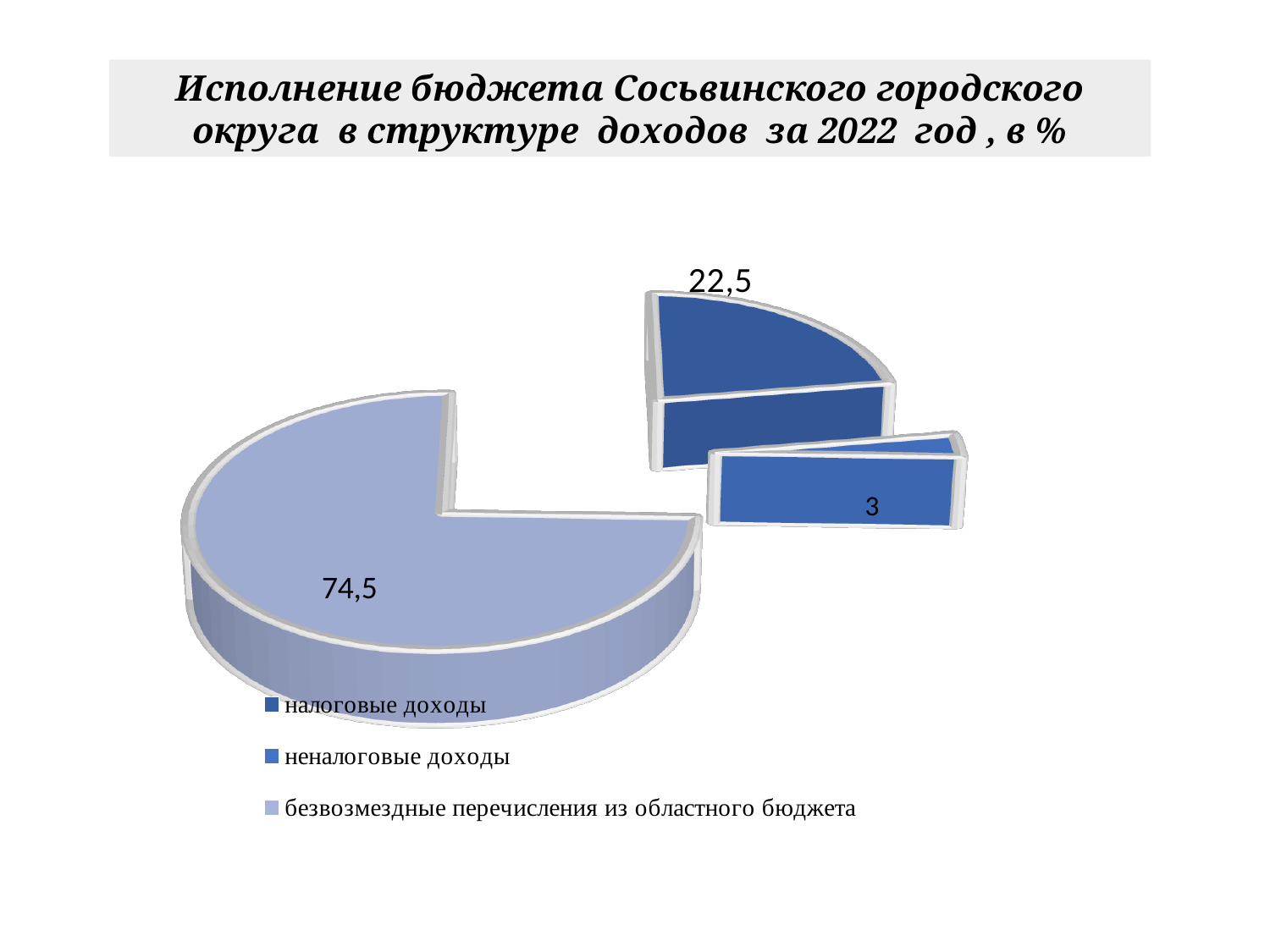
What is the difference between the values for безвозмездные перечисления из областного бюджета and налоговые доходы? 52 Which category has the smallest slice of the pie? неналоговые доходы How many entries does the legend list? 3 What kind of chart is shown on the slide? pie chart What is the value for налоговые доходы? 22,5 What is the value for неналоговые доходы? 3 What is the title of the chart? Исполнение бюджета Сосьвинского городского округа в структуре доходов за 2022 год , в % What is the difference between the values for налоговые доходы and неналоговые доходы? 19,5 What is the value for безвозмездные перечисления из областного бюджета? 74,5 Which is larger, налоговые доходы or неналоговые доходы? налоговые доходы Which category has the largest slice of the pie? безвозмездные перечисления из областного бюджета How many slices does the pie chart have? 3